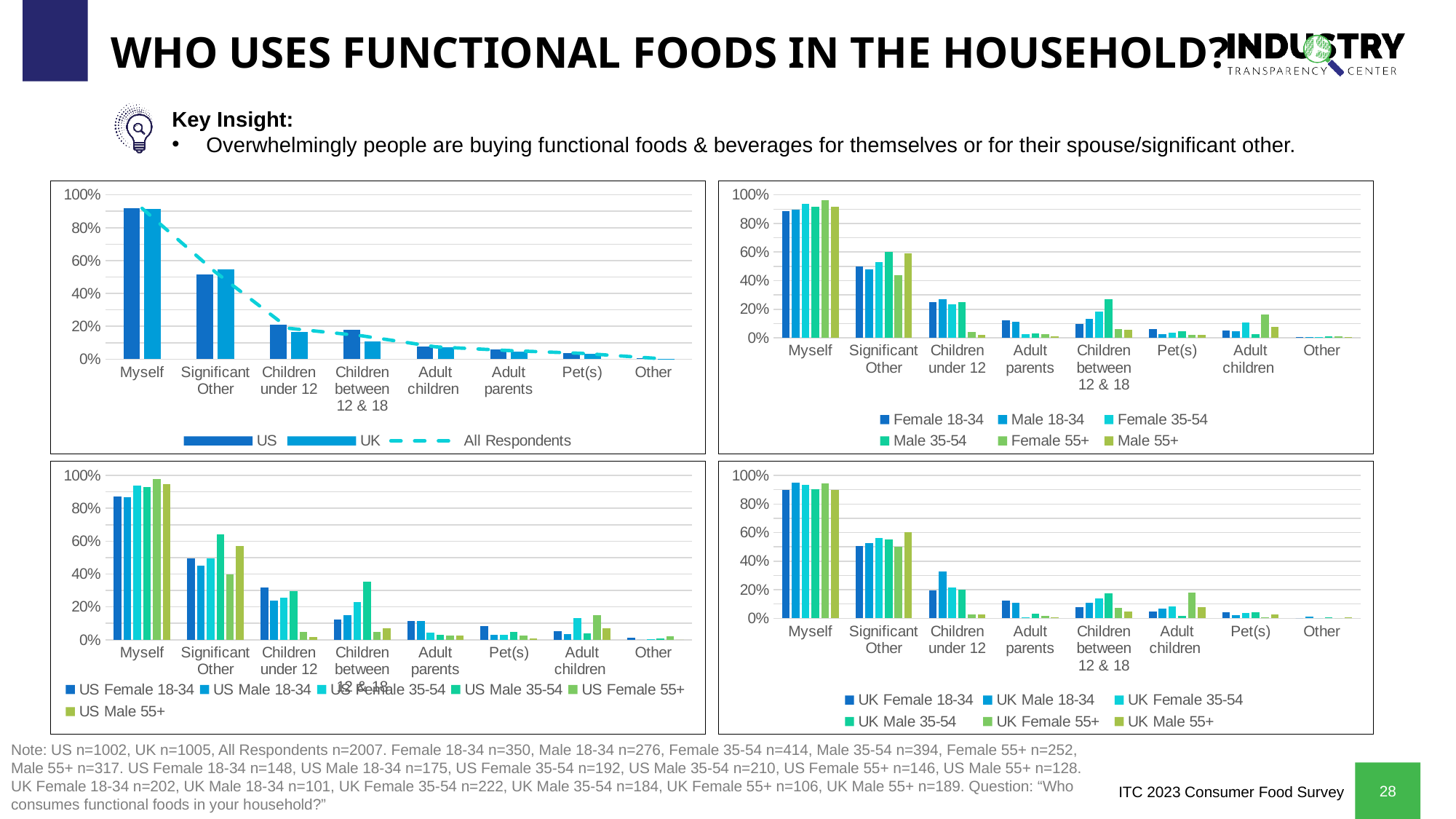
How many series does the legend of the top-left chart (US / UK / All Respondents) list? 3 In the top-left chart (US / UK / All Respondents), which is larger for Significant Other, US or UK? UK What kind of chart is the top-left chart (US / UK / All Respondents)? bar and line chart In the top-left chart (US / UK / All Respondents), is the UK value for Children under 12 greater or less than 20%? less In the bottom-left chart (US demographic groups), is the US Female 55+ value for Myself greater or less than 90%? greater In the top-left chart (US / UK / All Respondents), do the values rise or fall moving from Myself to Other along the x axis? fall How many series does the legend of the top-right chart (Female 18-34 through Male 55+) list? 6 How many categories are shown on the x axis of the top-left chart (US / UK / All Respondents)? 8 In the top-left chart (US / UK / All Respondents), which category has the highest values? Myself In the bottom-left chart (US demographic groups), which series has the highest value for Significant Other? US Male 35-54 In the top-left chart (US / UK / All Respondents), is the US value for Myself greater or less than 80%? greater In the bottom-right chart (UK demographic groups), which series has the highest value for Children under 12? UK Male 18-34